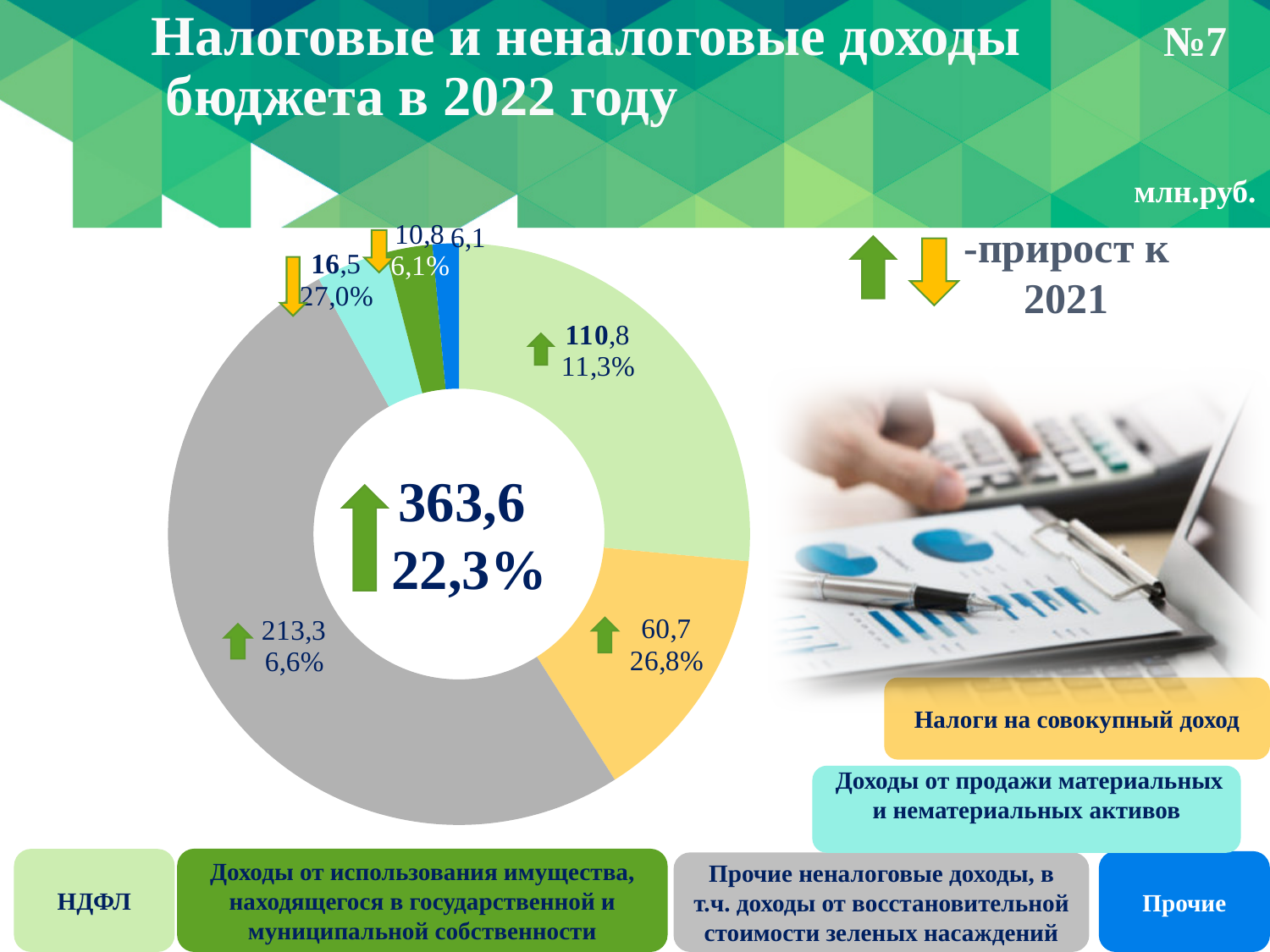
Which category has the smallest slice of the chart? Прочие Which is larger: the value for НДФЛ or the value for Налоги на совокупный доход? НДФЛ What total value is shown in the centre of the chart? 363,6 Which category has the largest slice of the chart? Прочие неналоговые доходы, в т.ч. доходы от восстановительной стоимости зеленых насаждений How many categories are shown in the chart? 6 What is the value for Доходы от продажи материальных и нематериальных активов? 16,5 What is the value for Прочие? 6,1 What is the value for НДФЛ? 110,8 What is the value for Налоги на совокупный доход? 60,7 What kind of chart is shown on the slide? doughnut chart What is the value for Прочие неналоговые доходы, в т.ч. доходы от восстановительной стоимости зеленых насаждений? 213,3 What is the difference between the value for Прочие неналоговые доходы and the value for НДФЛ? 102,5